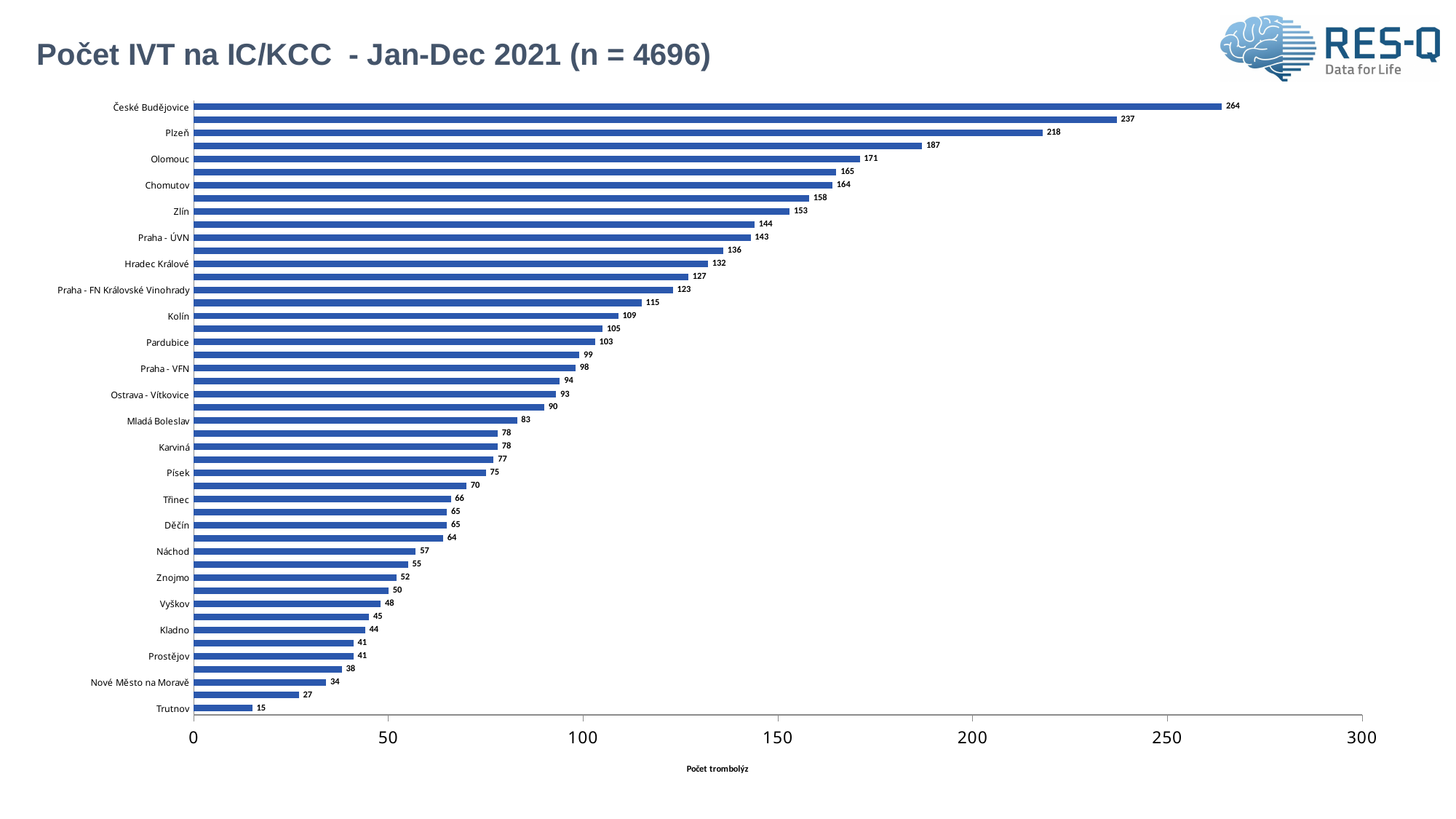
What is the value for Trutnov? 15 What is the title of the chart? Počet IVT na IC/KCC - Jan-Dec 2021 (n = 4696) What is the value for České Budějovice? 264 Which labelled category has the highest value? České Budějovice What is the difference between the values for Plzeň and Olomouc? 47 Which is larger, the value for Kolín or the value for Pardubice? Kolín What is the value for Plzeň? 218 Is the value for Zlín greater or less than 150? greater What is the value for Praha - ÚVN? 143 What is the label on the horizontal axis? Počet trombolýz What type of chart is shown on the slide? bar chart Which labelled category has the lowest value? Trutnov